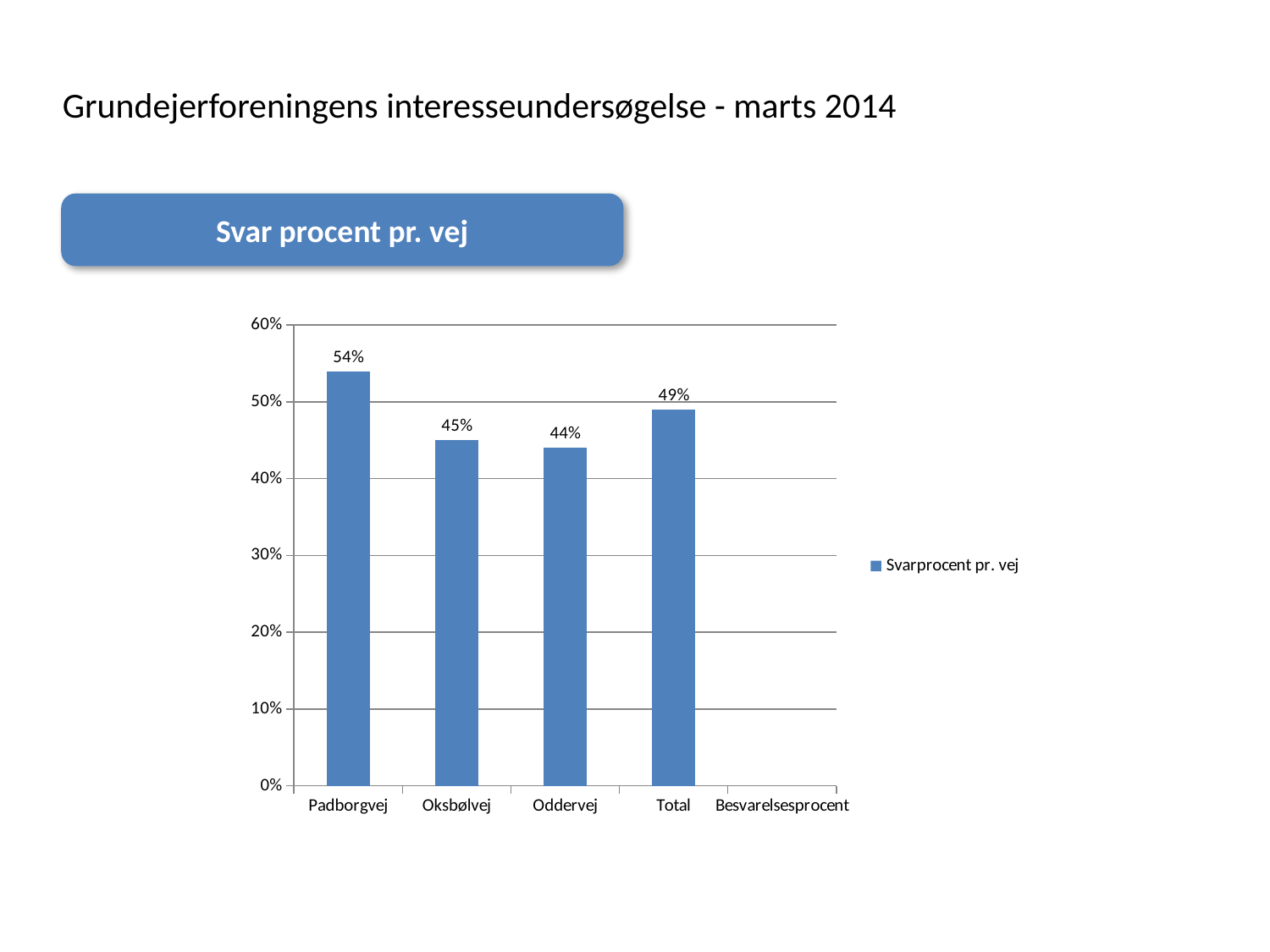
What kind of chart is shown? bar chart Which category has the highest value? Padborgvej Is the value for Padborgvej greater or less than 50%? greater What is the value for Total? 49% What is the value for Oddervej? 44% What is the value for Padborgvej? 54% What series name does the legend show? Svarprocent pr. vej Which is larger, the value for Oksbølvej or the value for Total? Total How many bars are plotted in the chart? 4 What is the difference between the values for Padborgvej and Oddervej? 10% What is the value for Oksbølvej? 45% Which category has the lowest plotted value? Oddervej